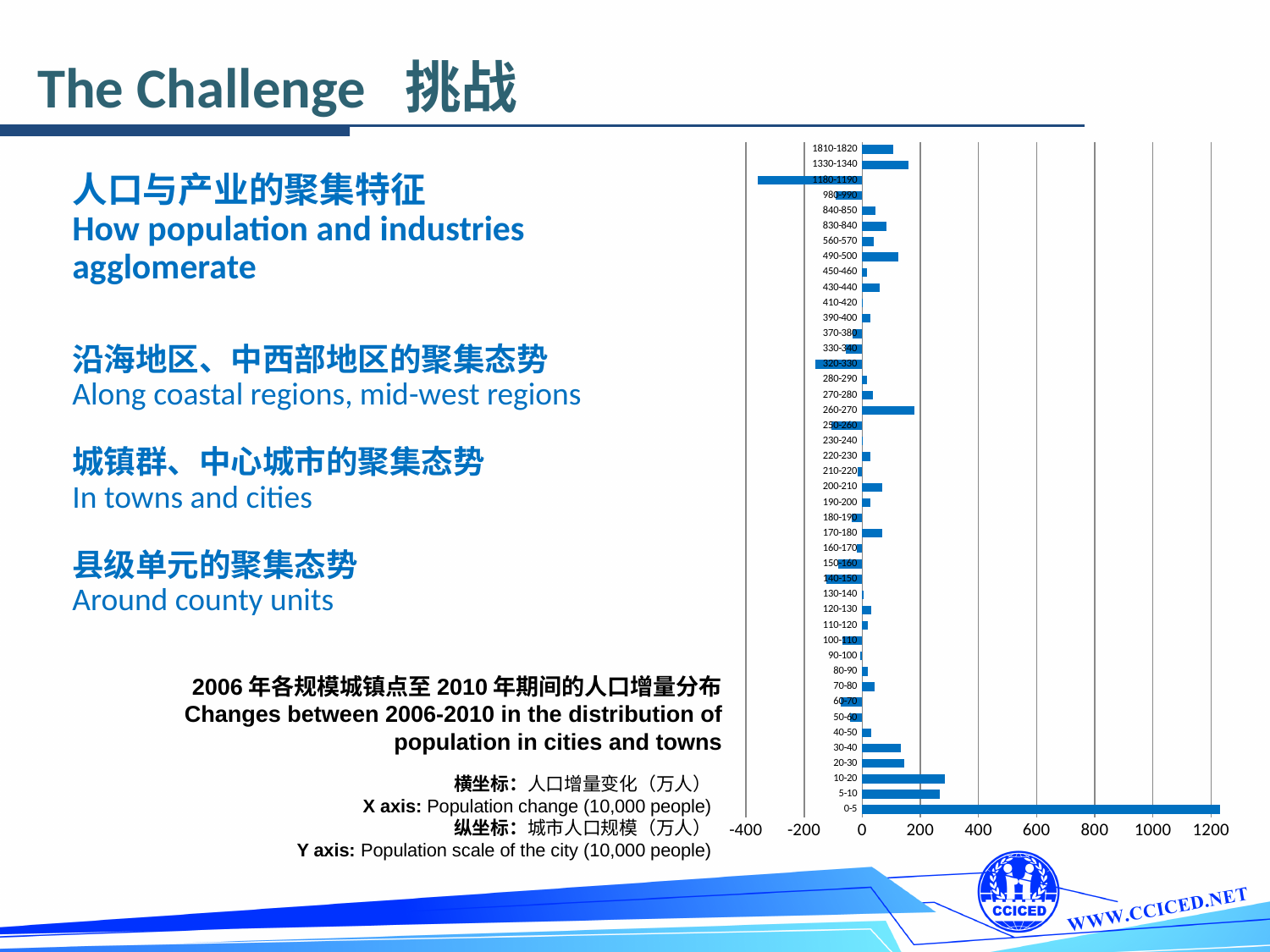
What does the X axis of the chart represent, according to the slide? Population change (10,000 people) Is the value for the 0-5 category greater or less than 1000? greater How many city population scale categories are plotted on the chart? 44 Which has the larger population change, the 1330-1340 category or the 1810-1820 category? 1330-1340 Is the value for the 10-20 category greater or less than 200? greater What kind of chart is shown on the slide? bar chart Which city population scale category has the lowest (most negative) population change? 1180-1190 Is the value for the 320-330 category greater or less than 0? less Which has the larger population change, the 0-5 category or the 10-20 category? 0-5 Which city population scale category has the highest population change? 0-5